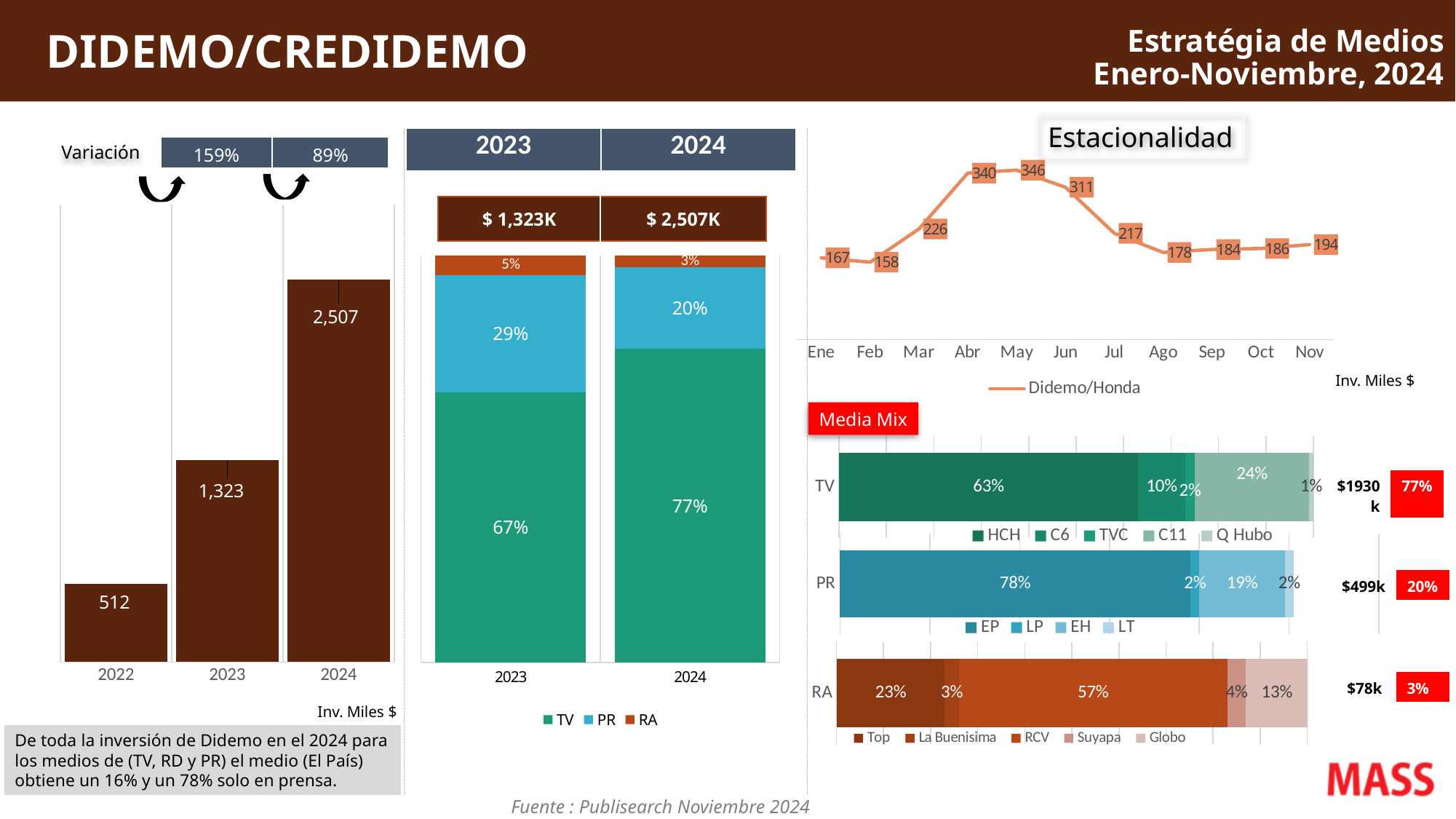
How many months are plotted in the Estacionalidad line chart? 11 In the bar chart on the left of the slide, which year has the lowest value? 2022 In the stacked bar chart in the middle of the slide, what share does TV have in 2024? 77% How many series does the legend of the stacked bar chart in the middle of the slide list? 3 In the stacked bar chart in the middle of the slide, what share does PR have in 2023? 29% In the Estacionalidad line chart, which month has the lowest value? Feb In the Estacionalidad line chart, what is the value for May? 346 In the bar chart on the left of the slide, what is the difference between the 2024 and 2023 values? 1,184 In the bar chart on the left of the slide, do the values rise or fall from 2022 to 2024? rise In the Media Mix chart, what share does EP have within the PR bar? 78% In the Media Mix chart, which is larger within the RA bar: Top or RCV? RCV In the bar chart on the left of the slide, what is the value for 2024? 2,507